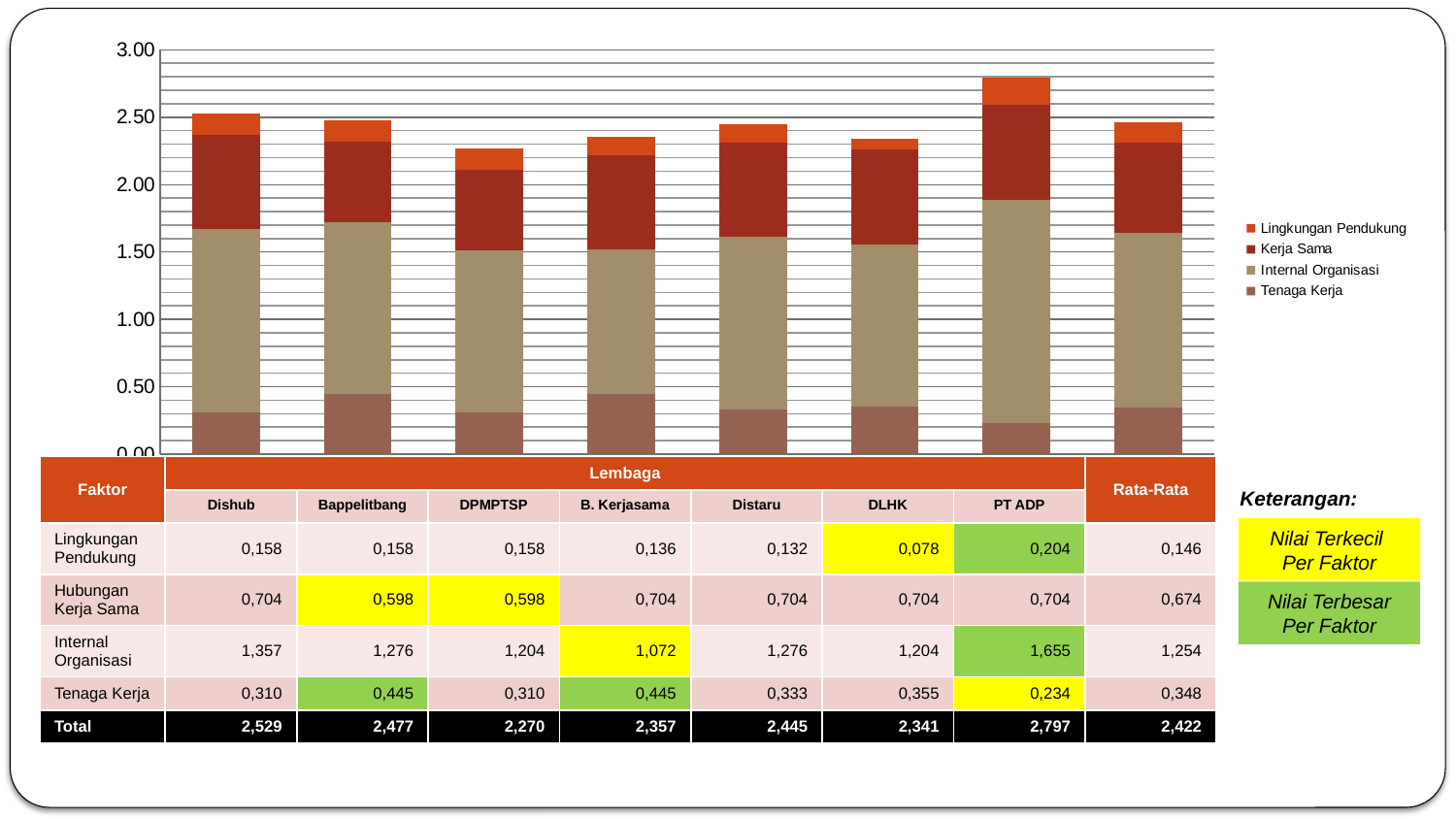
What is the Internal Organisasi value for PT ADP? 1,655 How many series does the chart legend list? 4 Which is larger, the total for Dishub or the total for DPMPTSP? Dishub Is the total for PT ADP greater or less than 2.50? greater What kind of chart is shown on the slide? Stacked bar chart How many bars are plotted in the chart? 8 What is the Tenaga Kerja value for Bappelitbang? 0,445 What is the total of the stacked bar for PT ADP? 2,797 Which bar has the highest total value? PT ADP Which legend entry is shown in the lightest brown (tan) colour? Internal Organisasi What is the Lingkungan Pendukung value for DLHK? 0,078 Which bar has the lowest total value? DPMPTSP